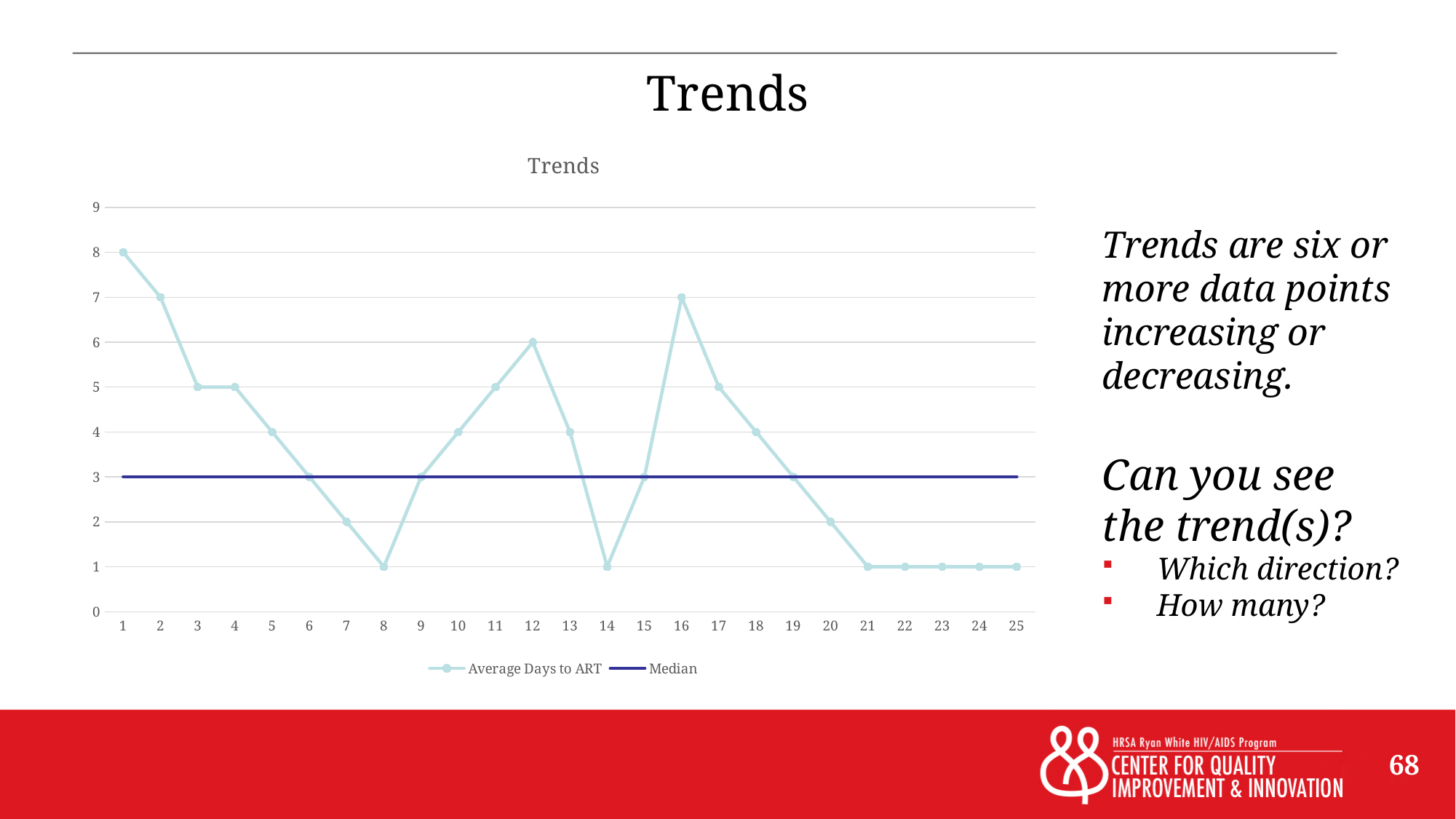
What is the title of the chart? Trends What kind of chart is shown on the slide? line chart Do the Average Days to ART values rise or fall from point 16 to point 21? fall At which point is Average Days to ART highest? 1 What is the value of Average Days to ART at point 16? 7 What is the lowest value of Average Days to ART on the chart? 1 How many series does the chart legend list? 2 Which is larger, Average Days to ART at point 12 or at point 16? point 16 How many data points are plotted for Average Days to ART? 25 What is the difference between Average Days to ART at point 1 and at point 8? 7 What is the value of the Median line? 3 What is the value of Average Days to ART at point 1? 8